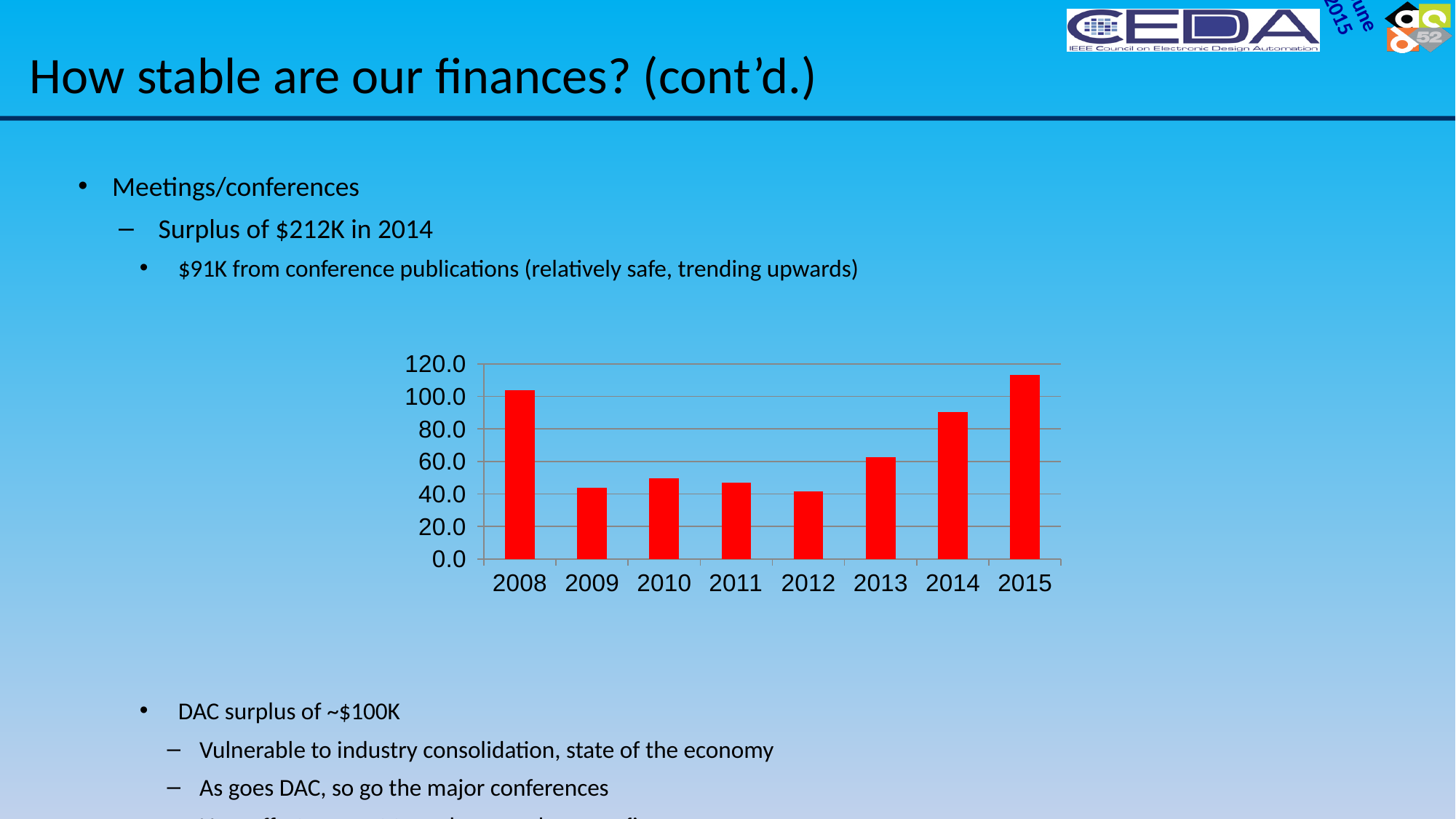
Which year has the highest bar in the chart? 2015 Is the value for 2009 greater or less than 60.0? less What colour are the bars in the chart? red What kind of chart is shown on the slide? bar chart How many years are shown on the x axis of the chart? 8 Is the value for 2013 greater or less than 60.0? greater Is the value for 2008 greater or less than 100.0? greater Which is larger, the value for 2008 or the value for 2014? 2008 Do the values rise or fall from 2012 to 2015? rise Which is larger, the value for 2013 or the value for 2012? 2013